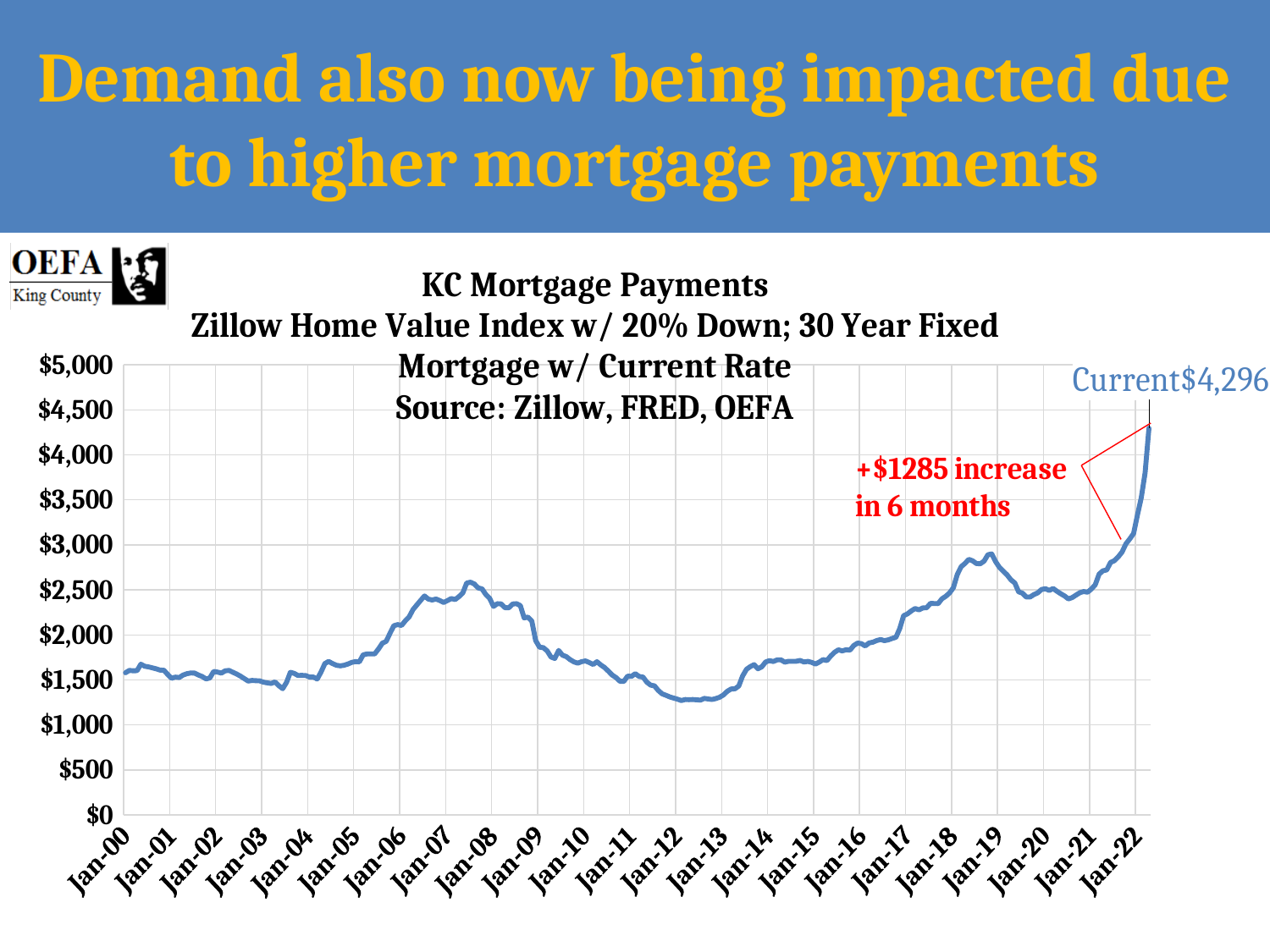
Between Jan-08 and Jan-12, do the mortgage payments rise or fall? fall How many year labels are shown on the x axis? 23 Is the value at Jan-19 greater or less than $2,500? greater Is the value at Jan-00 greater or less than $2,000? less Is the value at Jan-12 greater or less than $1,500? less What is the current KC mortgage payment labelled on the chart? $4,296 What is the highest value shown on the chart? $4,296 By how much does the annotation say the mortgage payment increased in 6 months? +$1285 What is the title of the chart? KC Mortgage Payments What kind of chart is shown on the slide? line chart Between Jan-13 and Jan-18, do the mortgage payments rise or fall? rise